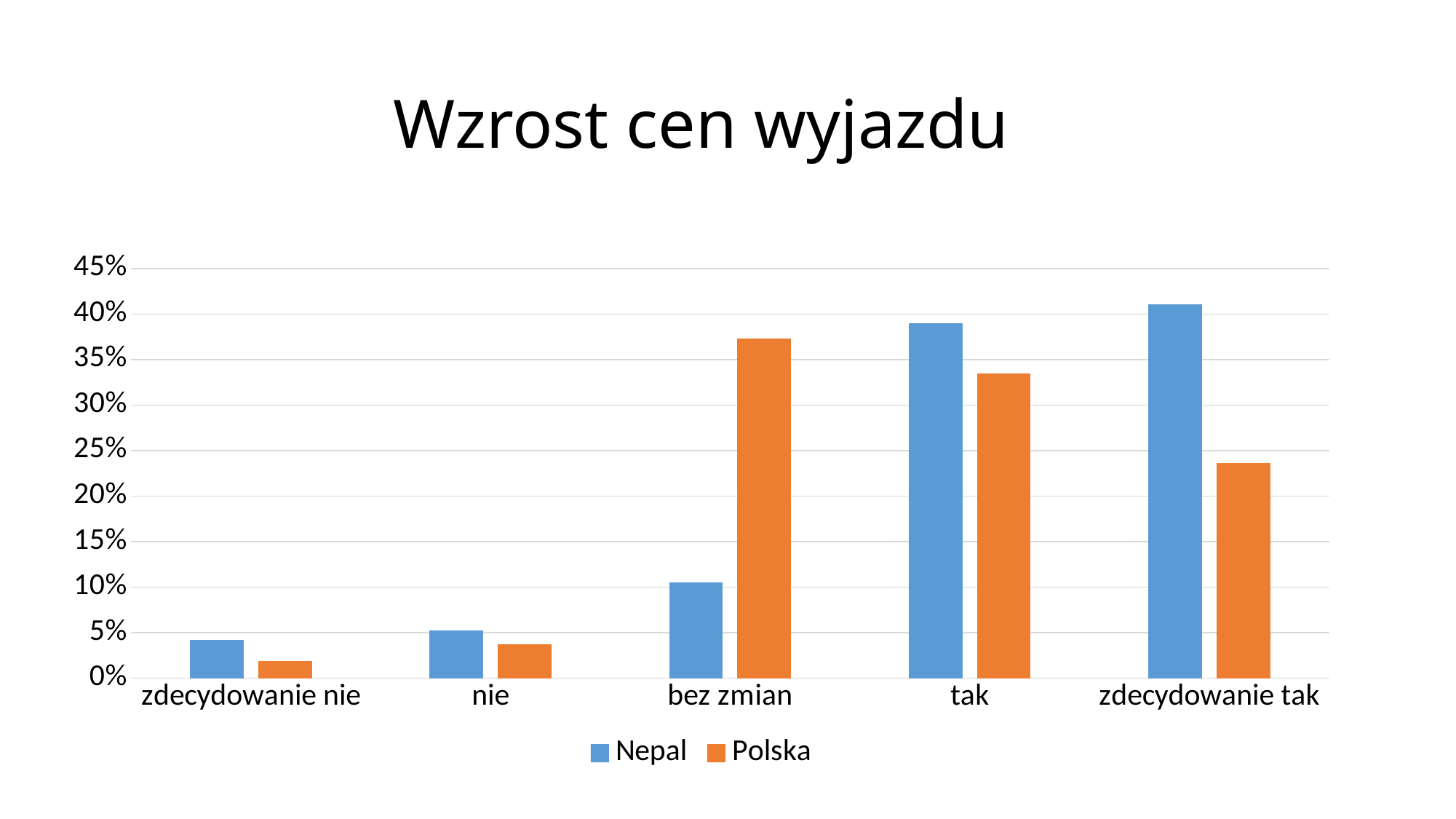
How many categories are shown on the x axis? 5 What is the title of the chart? Wzrost cen wyjazdu Is the value for Nepal in the category tak greater or less than 35%? greater For the category bez zmian, which series has the larger value, Nepal or Polska? Polska How many series does the legend list? 2 Which category has the highest value for Polska? bez zmian Which colour represents the Polska series in the chart? orange For the category zdecydowanie tak, which series has the larger value, Nepal or Polska? Nepal Is the value for Polska in the category zdecydowanie tak greater or less than 20%? greater What kind of chart is shown on the slide? bar chart Which category has the lowest value for Polska? zdecydowanie nie Is the value for Nepal in the category nie greater or less than 10%? less